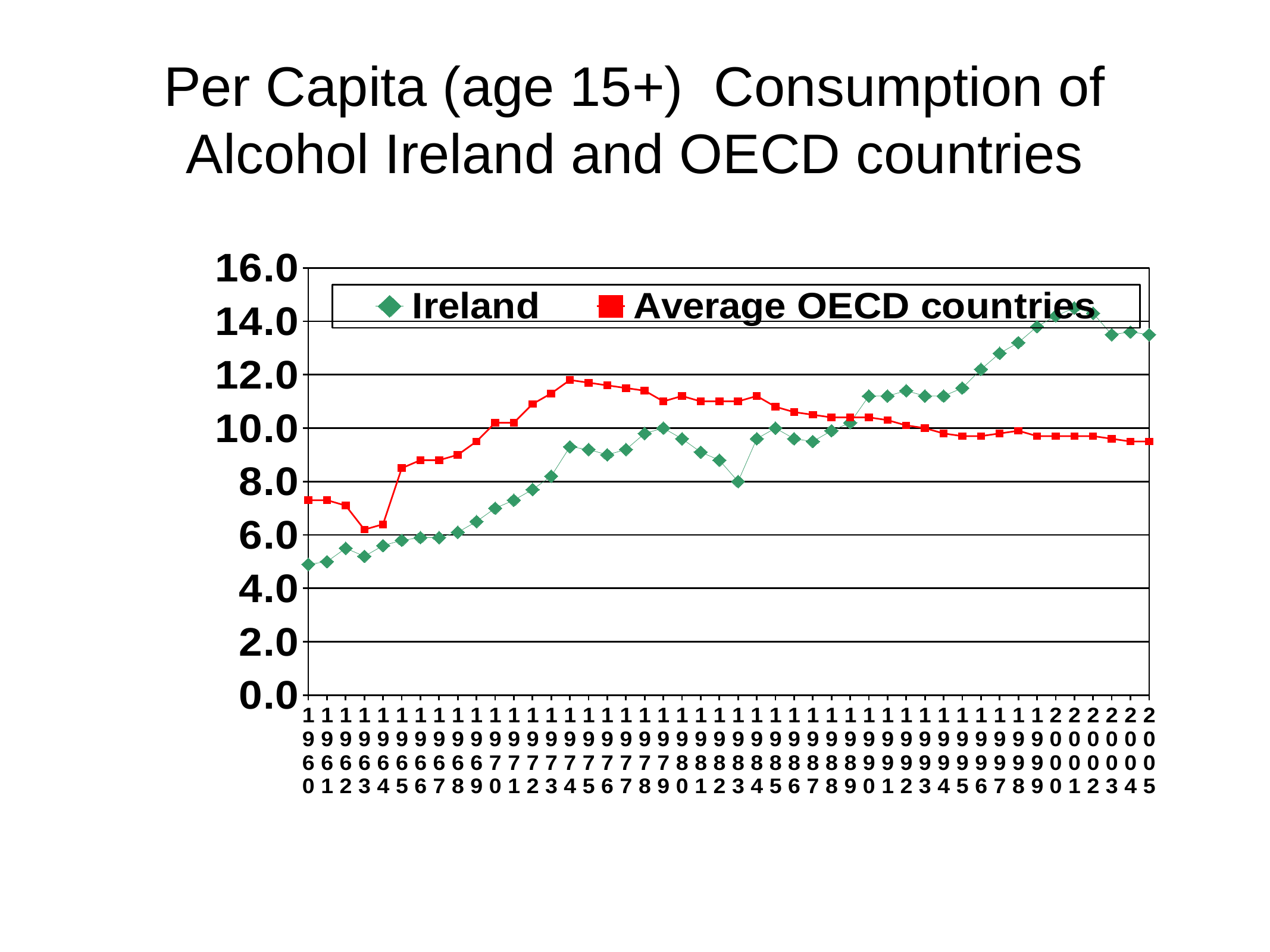
What colour is the Ireland series plotted in? green What kind of chart is shown on the slide? line chart Is the value for Ireland in 2005 greater or less than 12.0? greater Is the value for Average OECD countries in 2005 greater or less than 10.0? less Which two series are shown in the legend? Ireland and Average OECD countries Is the value for Average OECD countries in 1974 greater or less than 10.0? greater In 1970, which series has the higher value, Ireland or Average OECD countries? Average OECD countries In 2005, which series has the higher value, Ireland or Average OECD countries? Ireland How many years are plotted along the x axis? 46 How many series does the legend list? 2 Does the Ireland series generally rise or fall from 1960 to 2005? rise